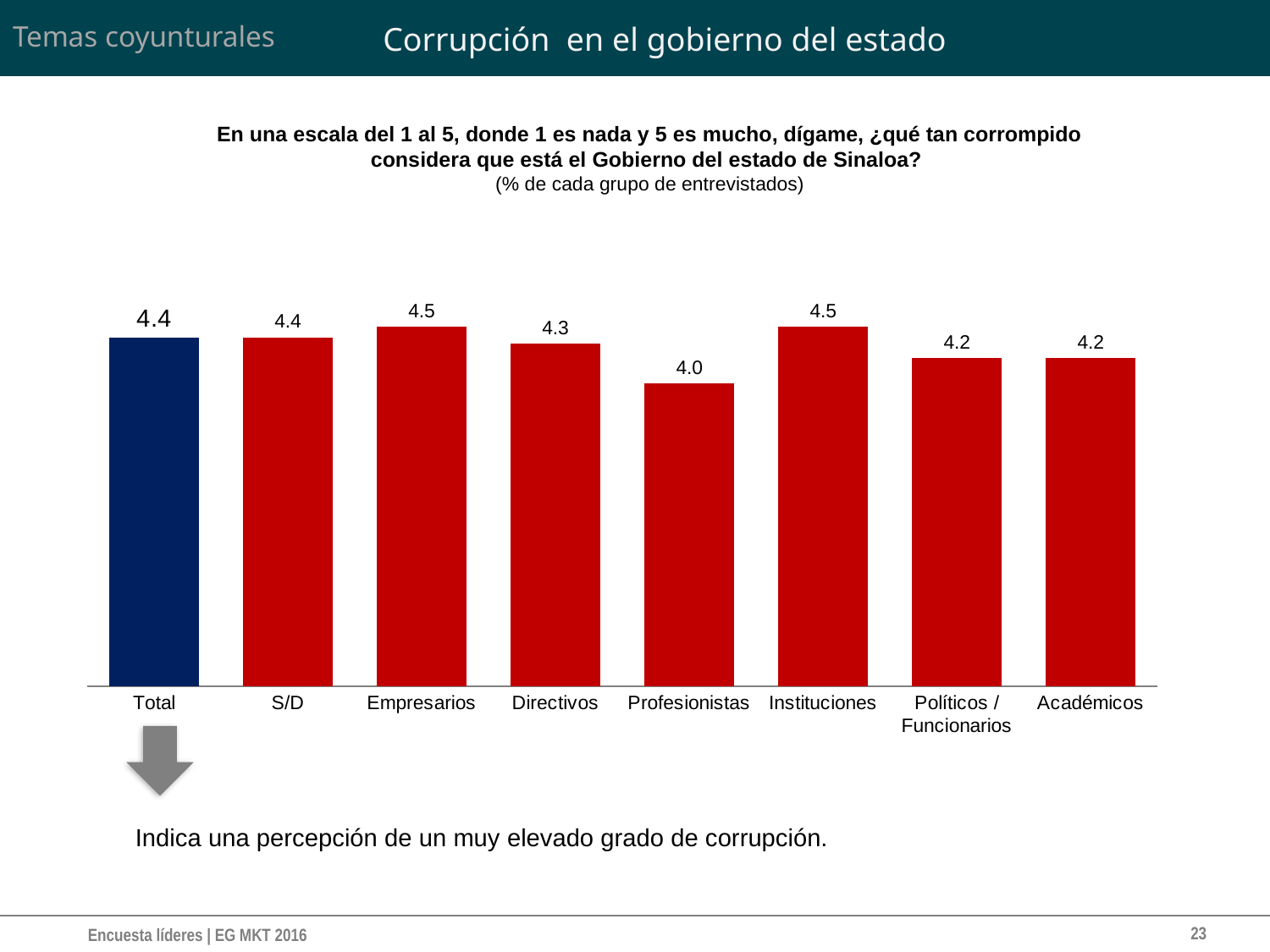
Which is larger, the value for S/D or the value for Profesionistas? S/D How many categories are shown on the x axis? 8 What kind of chart is shown on the slide? Bar chart What is the value for Académicos? 4.2 What is the value for Directivos? 4.3 What is the difference between the values for Directivos and Políticos / Funcionarios? 0.1 What is the value for Total? 4.4 Which is larger, the value for Instituciones or the value for Académicos? Instituciones What is the value for Profesionistas? 4.0 What is the difference between the values for Empresarios and Profesionistas? 0.5 Which bar is shown in a different colour (dark blue) from the others? Total Which category has the lowest value? Profesionistas